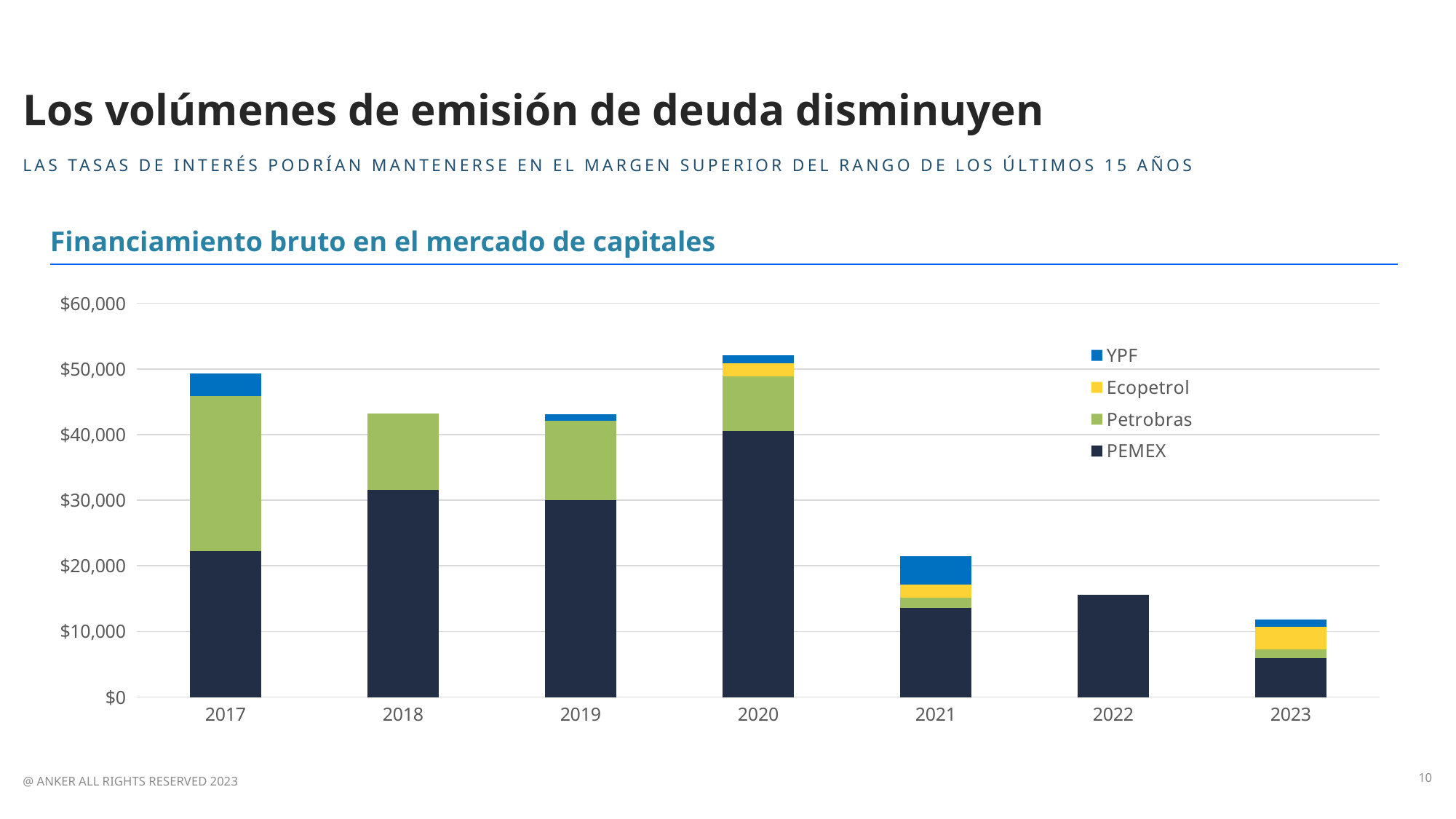
What kind of chart is shown on the slide? Stacked bar chart Which year has the highest total gross financing in the chart? 2020 How many years are shown on the x axis of the chart? 7 Is the total value for 2022 greater or less than $20,000? less Is the total value for 2023 greater or less than $10,000? greater How many series does the chart legend list? 4 Is the PEMEX value for 2018 greater or less than $30,000? greater Which year has the lowest total gross financing in the chart? 2023 Which year has the larger total, 2017 or 2018? 2017 Which year has the larger PEMEX value, 2017 or 2020? 2020 Which series is shown in yellow in the chart? Ecopetrol